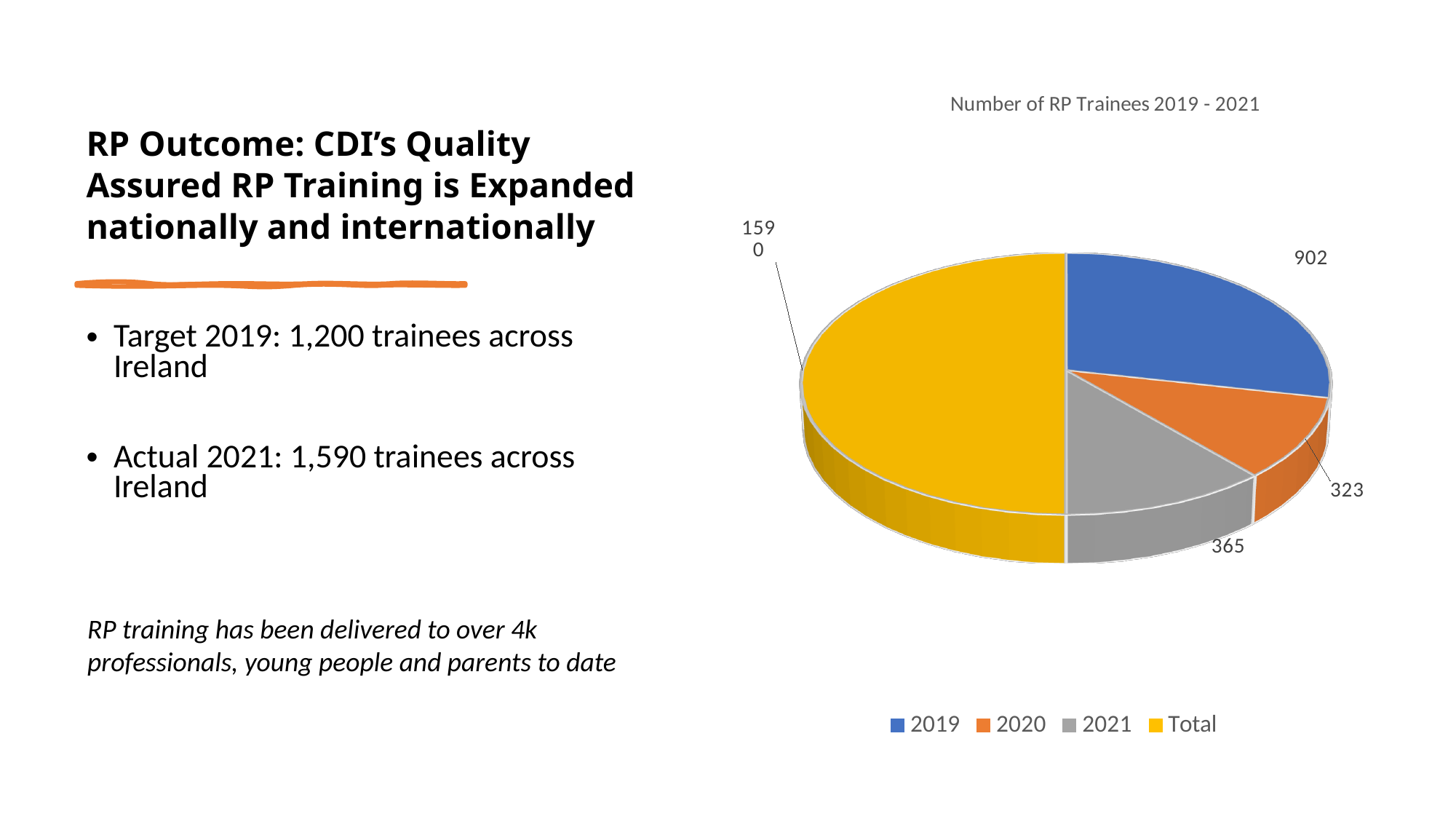
What is the value for 2019 in the pie chart? 902 Which slice of the pie chart is the smallest? 2020 What is the value for 2020 in the pie chart? 323 What is the value for 2021 in the pie chart? 365 Which slice of the pie chart is the largest? Total Which is larger, the value for 2021 or the value for 2020? 2021 How many entries does the chart legend list? 4 What is the difference between the values for 2021 and 2020? 42 What kind of chart is shown on the slide? pie chart What is the title of the chart? Number of RP Trainees 2019 - 2021 Which colour represents 2021 in the pie chart? grey What is the difference between the values for 2019 and 2020? 579